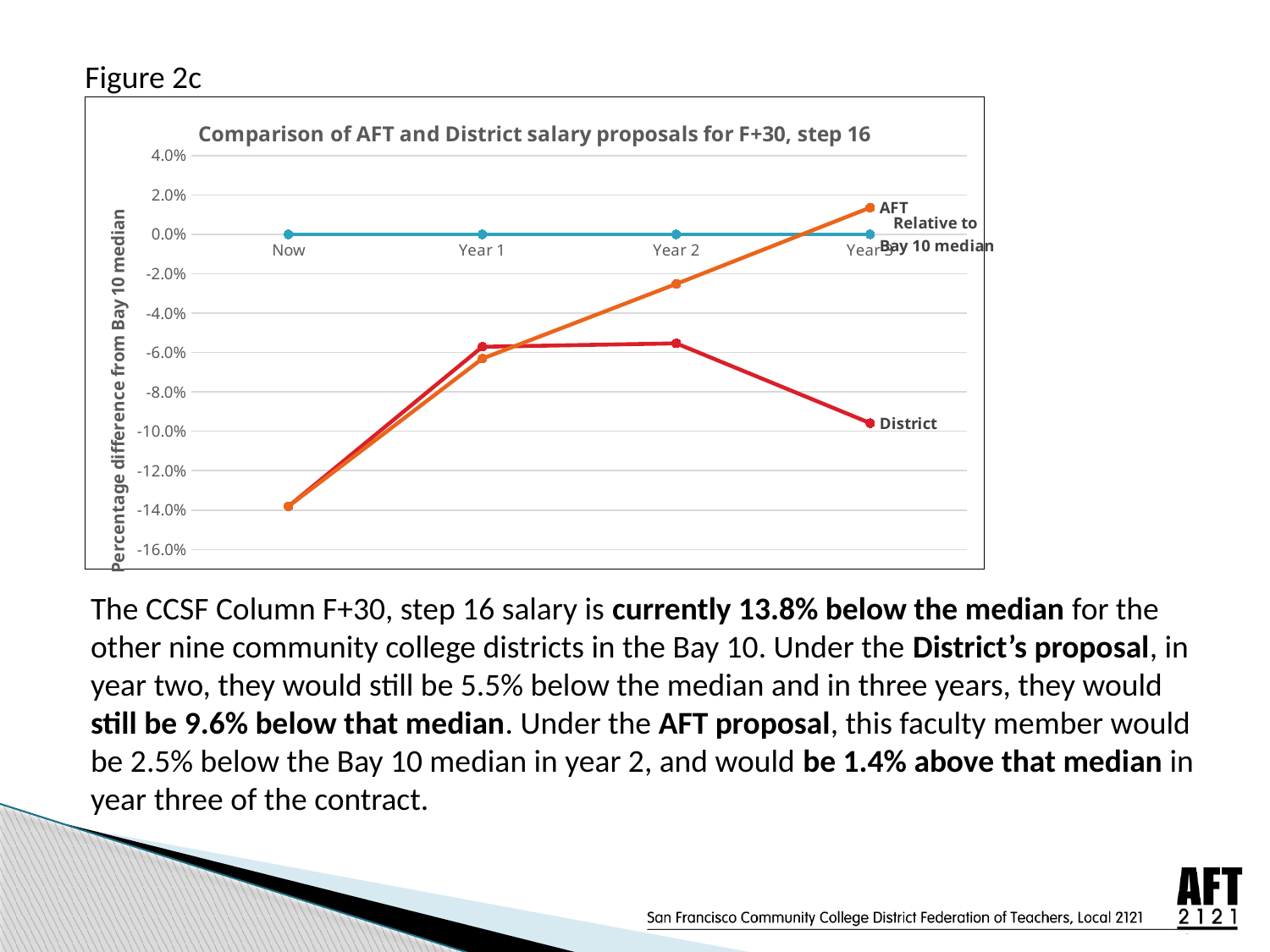
Is the value for AFT at Now greater or less than -12.0%? less Is the value for AFT at Year 2 greater or less than -4.0%? greater Is the value for District at Year 3 greater or less than -8.0%? less How many series are plotted in the chart? 3 How many points are plotted along the x axis for each series? 4 Does the AFT line rise or fall from Now to Year 3? rises What is the value of the Relative to Bay 10 median line at Year 1? 0.0% At which x-axis point is the AFT series at its lowest? Now What is the title of the chart? Comparison of AFT and District salary proposals for F+30, step 16 At Year 3, which series has the higher value, AFT or District? AFT What kind of chart is shown on the slide? line chart